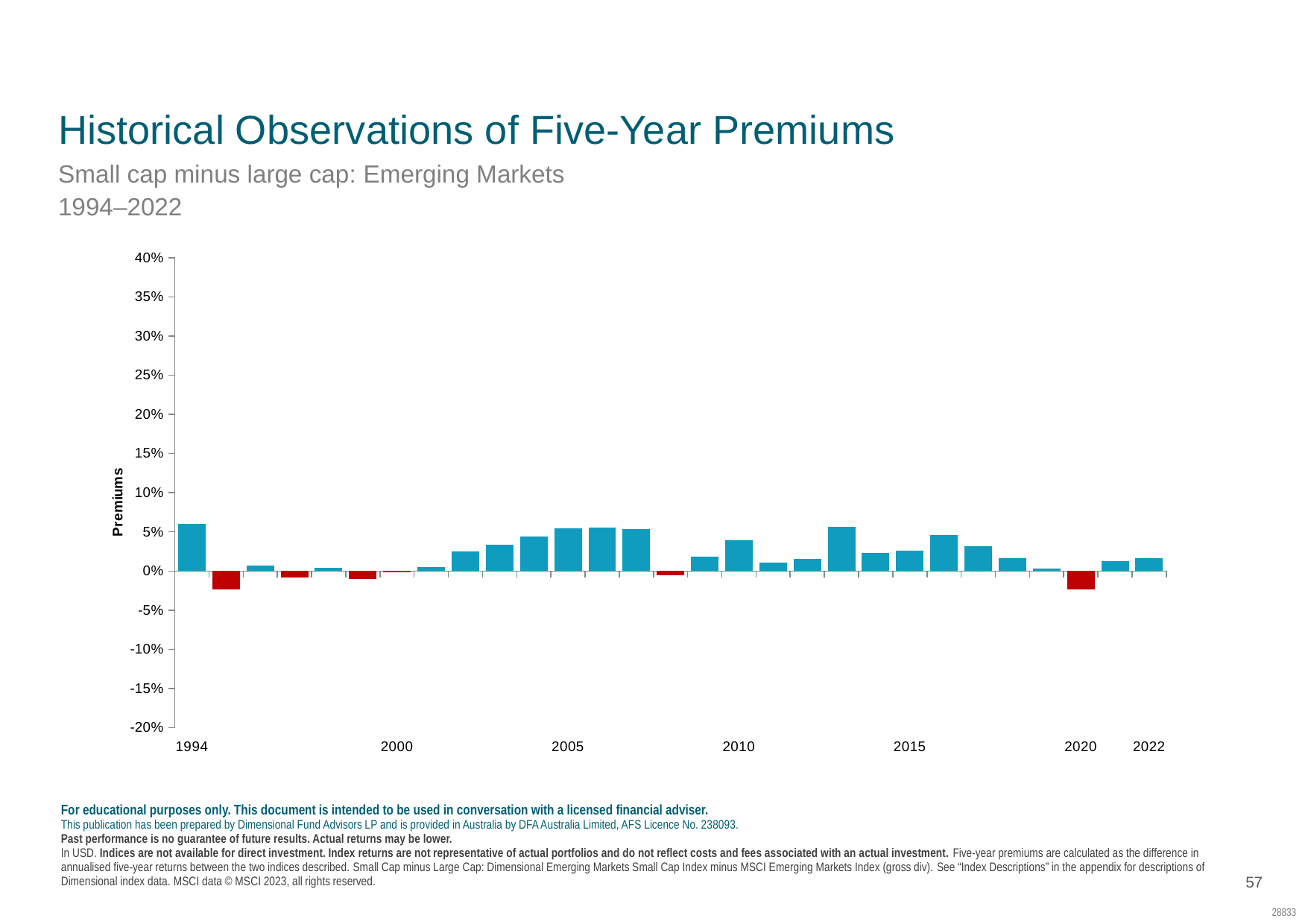
What is the label on the vertical axis of the chart? Premiums How many yearly bars are plotted in the chart (1994 through 2022)? 29 Is the value for 1994 greater or less than 5%? greater Is the value for 2010 greater or less than 5%? less Which year has the larger value, 2000 or 2005? 2005 What kind of chart is shown on the slide? Bar chart Is the value for 2020 greater or less than 0%? less What is the title of the chart on the slide? Historical Observations of Five-Year Premiums Which year has the larger value, 1994 or 2020? 1994 Which year has the larger value, 2010 or 2015? 2010